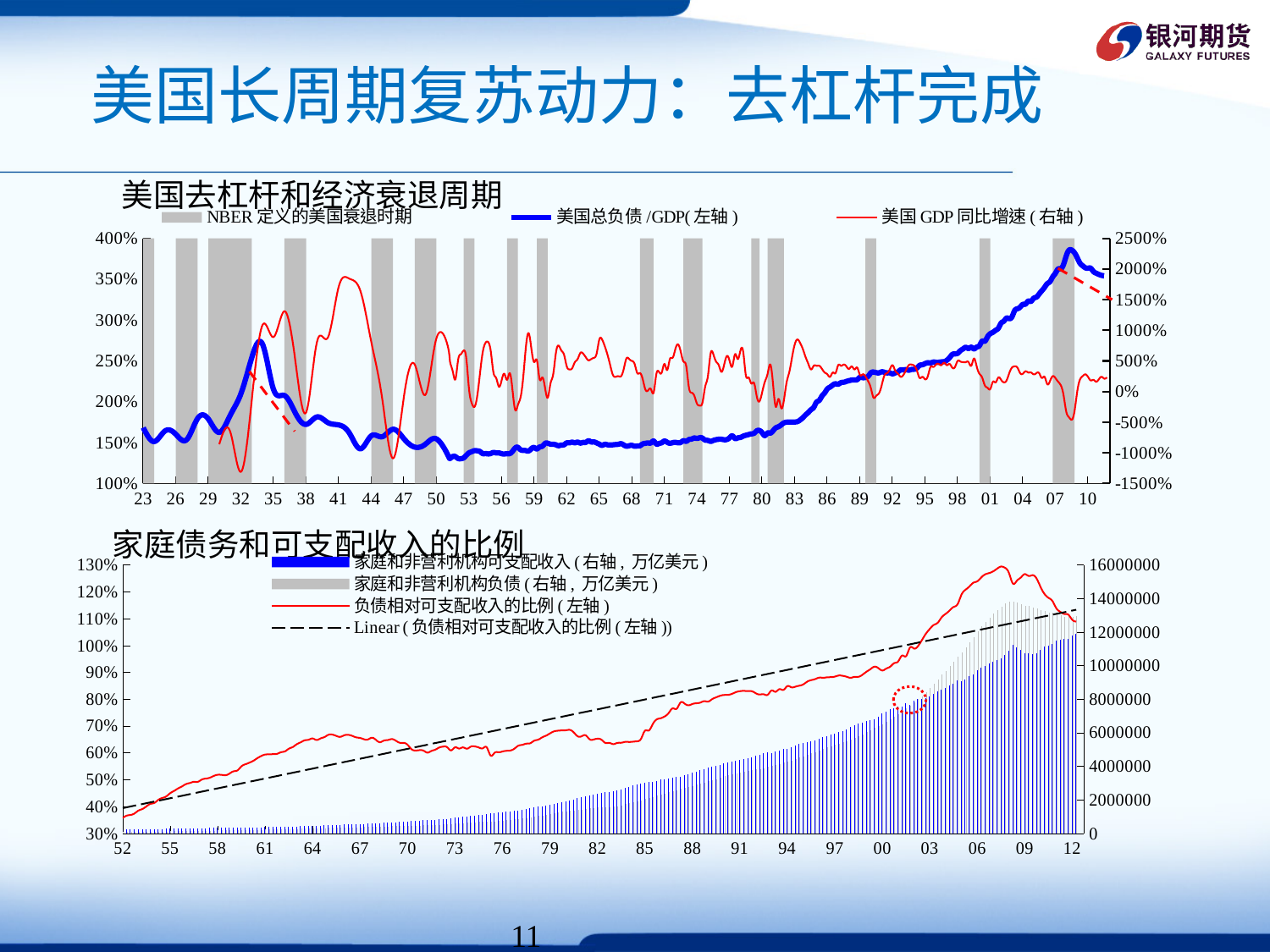
In the bottom chart titled 家庭债务和可支配收入的比例, is the value of 家庭和非营利机构可支配收入 in 2012 greater or less than 10000000? greater In the bottom chart titled 家庭债务和可支配收入的比例, is the peak value of 负债相对可支配收入的比例 around 2007 greater or less than 120%? greater In the bottom chart titled 家庭债务和可支配收入的比例, how many entries does the legend list? 4 In the top chart titled 美国去杠杆和经济衰退周期, what do the grey shaded bands represent according to the legend? NBER 定义的美国衰退时期 In the top chart titled 美国去杠杆和经济衰退周期, does 美国总负债/GDP rise or fall between 1980 and 2008? rise In the top chart titled 美国去杠杆和经济衰退周期, is the peak value of 美国总负债/GDP around 2008 greater or less than 350%? greater In the bottom chart titled 家庭债务和可支配收入的比例, do the 家庭和非营利机构可支配收入 bars generally rise or fall from 1952 to 2012? rise In the bottom chart titled 家庭债务和可支配收入的比例, which legend entry is drawn as a dashed line? Linear (负债相对可支配收入的比例(左轴)) In the top chart titled 美国去杠杆和经济衰退周期, how many series does the legend list? 3 In the top chart titled 美国去杠杆和经济衰退周期, what kind of chart is used to plot 美国总负债/GDP and 美国GDP同比增速? line chart